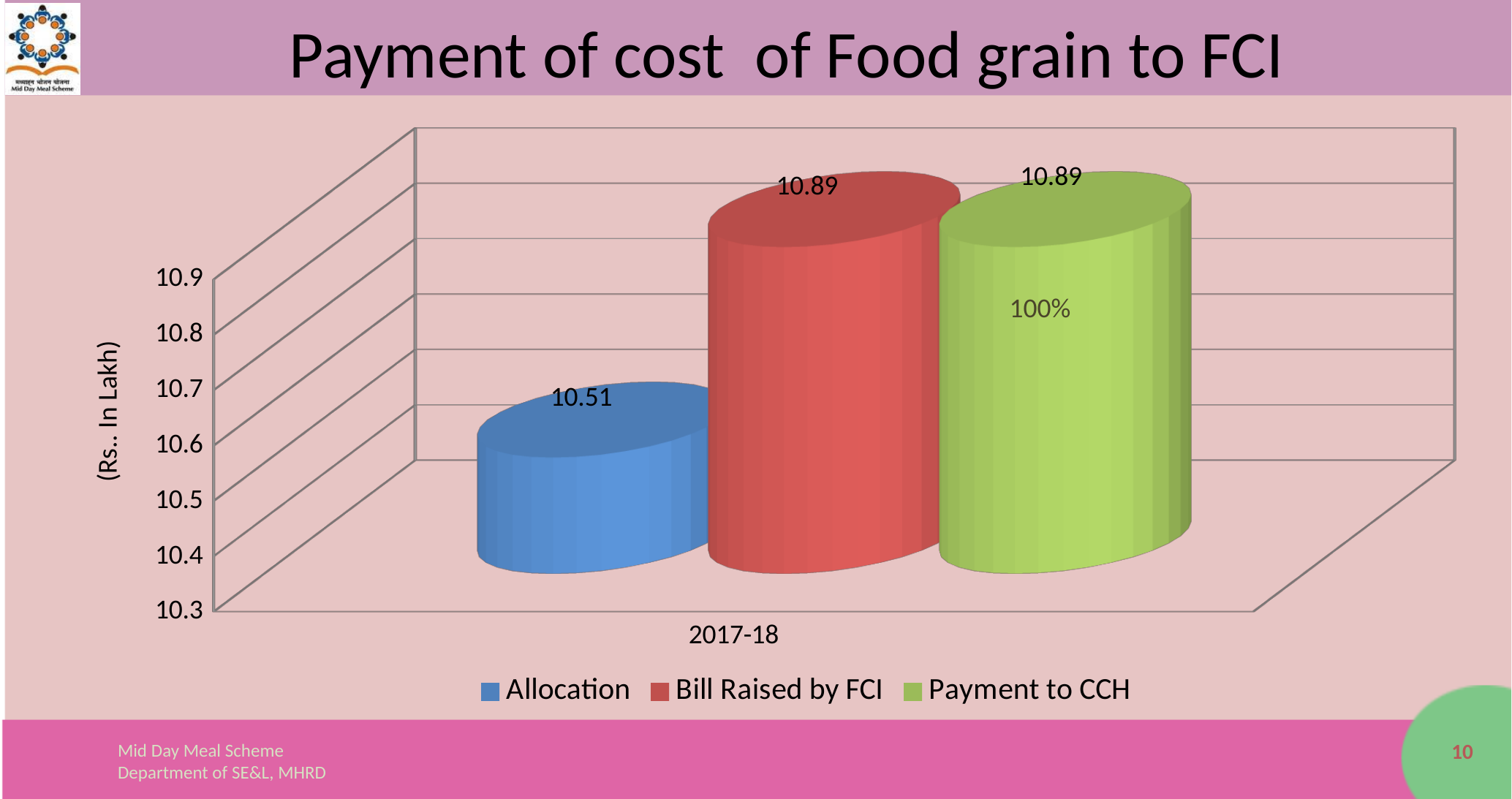
What is the value for Allocation in 2017-18? 10.51 Is the value for Allocation greater or less than 10.6? less What is the value for Bill Raised by FCI in 2017-18? 10.89 How many categories are shown on the x axis? 1 What is the title of the chart? Payment of cost of Food grain to FCI Which is larger in 2017-18, Allocation or Payment to CCH? Payment to CCH What kind of chart is shown on the slide? Bar chart What is the value for Payment to CCH in 2017-18? 10.89 What is the difference between Bill Raised by FCI and Allocation in 2017-18? 0.38 How many series does the legend list? 3 Which series has the lowest value in 2017-18? Allocation What unit is shown on the y axis label? (Rs.. In Lakh)